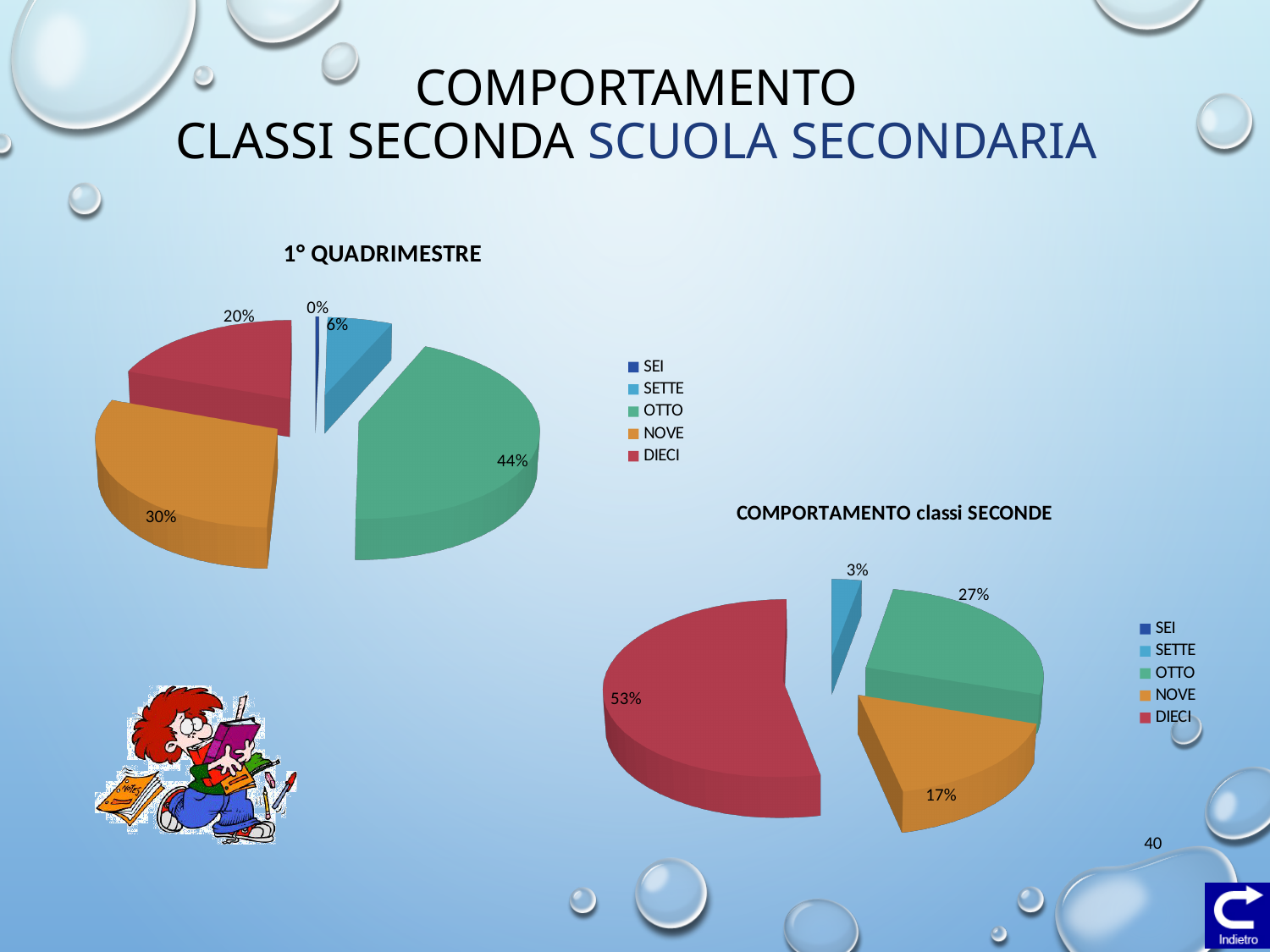
In the 'COMPORTAMENTO classi SECONDE' chart, what share does OTTO have? 27% In the '1° QUADRIMESTRE' chart, what share does OTTO have? 44% In the 'COMPORTAMENTO classi SECONDE' chart, which category has the largest slice? DIECI In the '1° QUADRIMESTRE' chart, what share does NOVE have? 30% In the '1° QUADRIMESTRE' chart, what share does DIECI have? 20% In the 'COMPORTAMENTO classi SECONDE' chart, what share does NOVE have? 17% In the 'COMPORTAMENTO classi SECONDE' chart, what share does DIECI have? 53% How many entries does the legend of the '1° QUADRIMESTRE' chart list? 5 In the '1° QUADRIMESTRE' chart, what share does SETTE have? 6% In the '1° QUADRIMESTRE' chart, which is larger, NOVE or DIECI? NOVE In the '1° QUADRIMESTRE' chart, which category has the largest slice? OTTO In the 'COMPORTAMENTO classi SECONDE' chart, what is the difference between the DIECI and OTTO shares? 26%